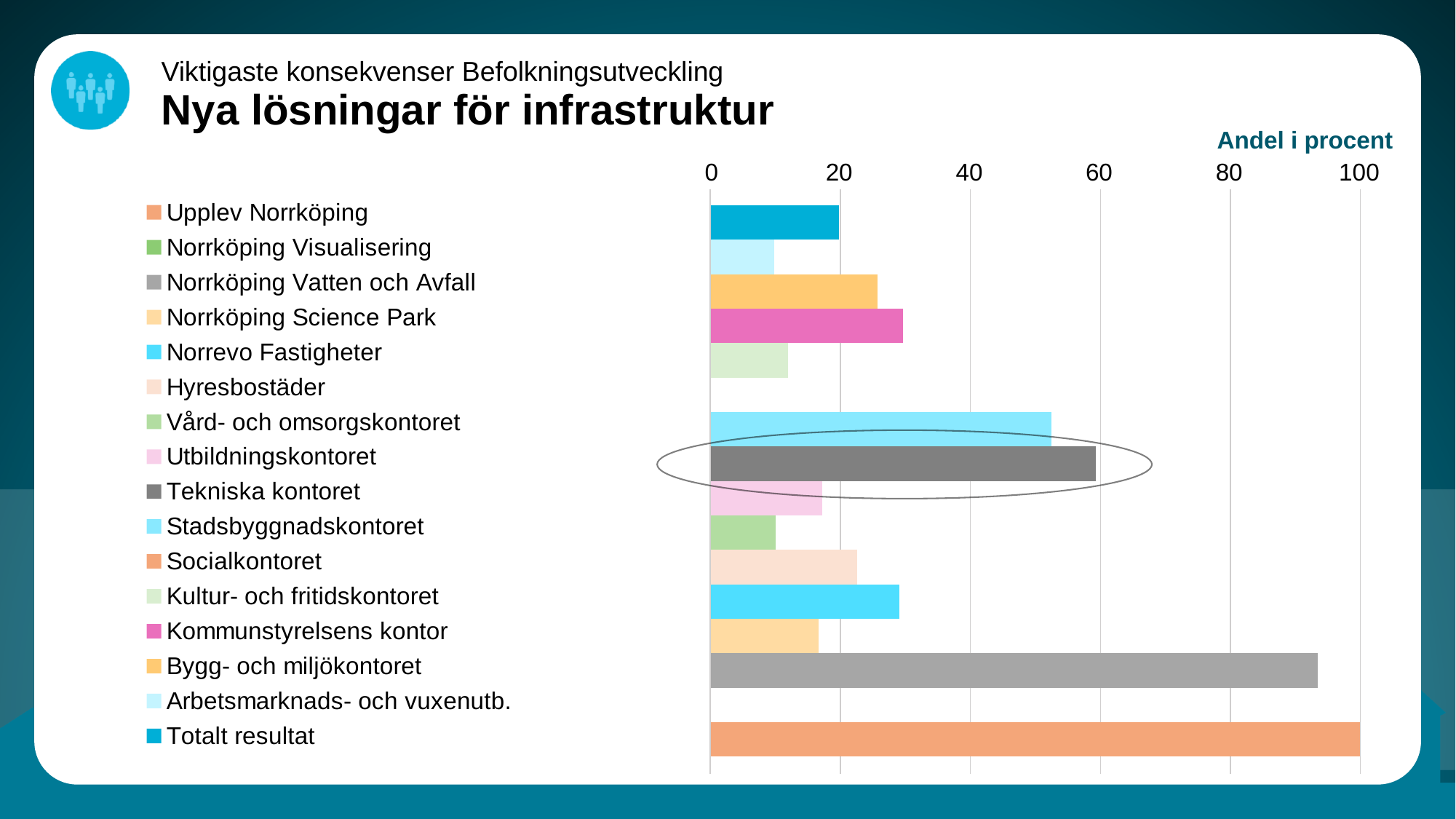
What is the label shown above the horizontal axis? Andel i procent Which is larger, the value for Tekniska kontoret or the value for Utbildningskontoret? Tekniska kontoret Which is larger, the value for Norrköping Vatten och Avfall or the value for Stadsbyggnadskontoret? Norrköping Vatten och Avfall Is the value for Tekniska kontoret greater or less than 40? greater What is the value for Upplev Norrköping? 100 Which category has the highest value? Upplev Norrköping Is the value for Kommunstyrelsens kontor greater or less than 40? less How many entries does the legend list? 16 Is the value for Stadsbyggnadskontoret greater or less than 60? less Which category's bar is circled on the chart? Tekniska kontoret What kind of chart is shown on the slide? bar chart